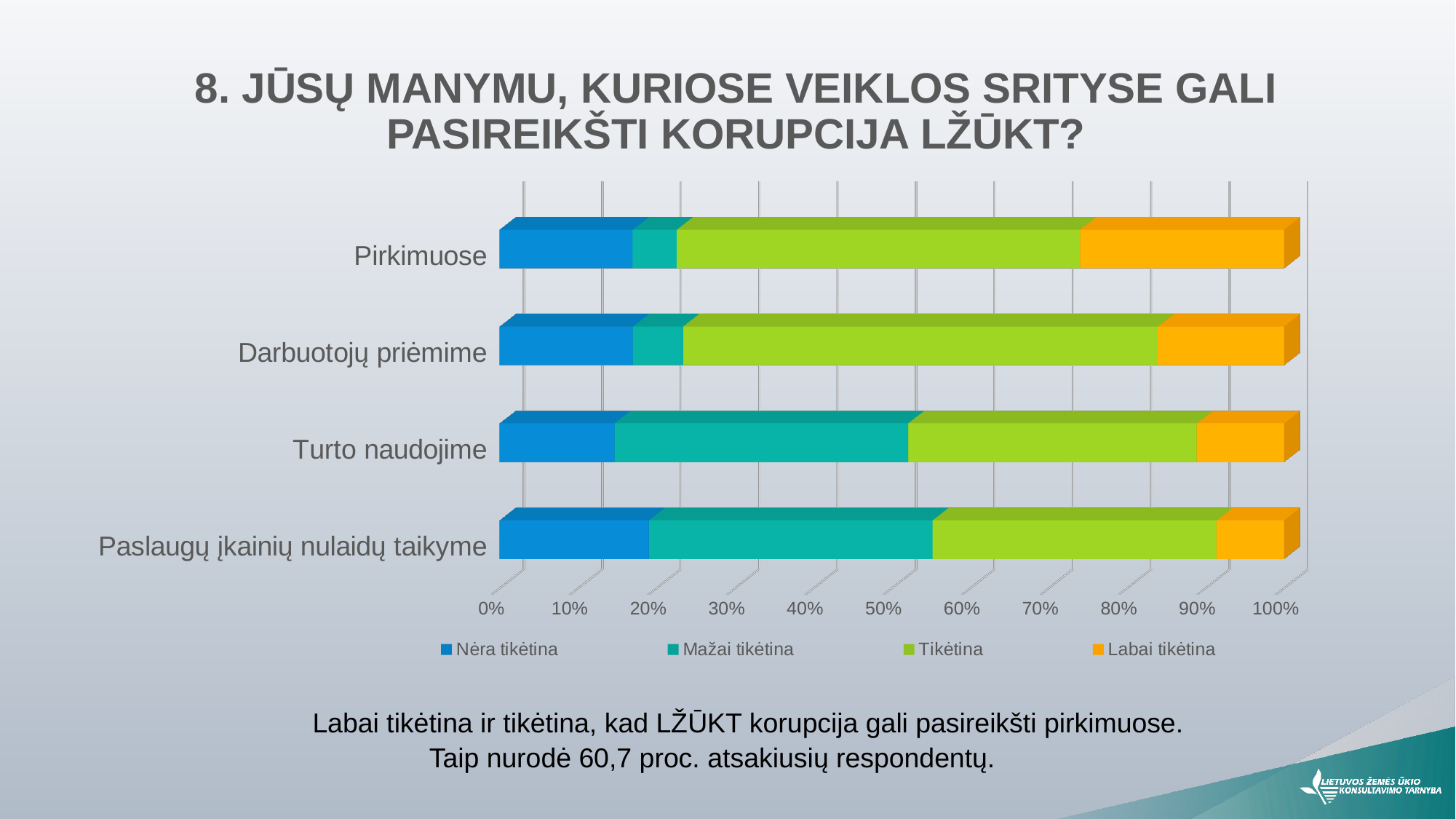
Which category has the largest "Tikėtina" segment? Darbuotojų priėmime Which category has the largest "Labai tikėtina" segment? Pirkimuose How many categories (activity areas) are shown on the chart? 4 How many series does the legend list? 4 Is the "Tikėtina" value for Darbuotojų priėmime greater or less than 50%? greater Which is larger: the "Labai tikėtina" segment for Pirkimuose or for Paslaugų įkainių nulaidų taikyme? Pirkimuose What kind of chart is shown on the slide? Stacked bar chart Which is larger: the "Mažai tikėtina" segment for Turto naudojime or for Pirkimuose? Turto naudojime What colour represents the "Labai tikėtina" series in the legend? Orange Is the "Labai tikėtina" value for Pirkimuose greater or less than 20%? greater Is the "Mažai tikėtina" value for Pirkimuose greater or less than 10%? less